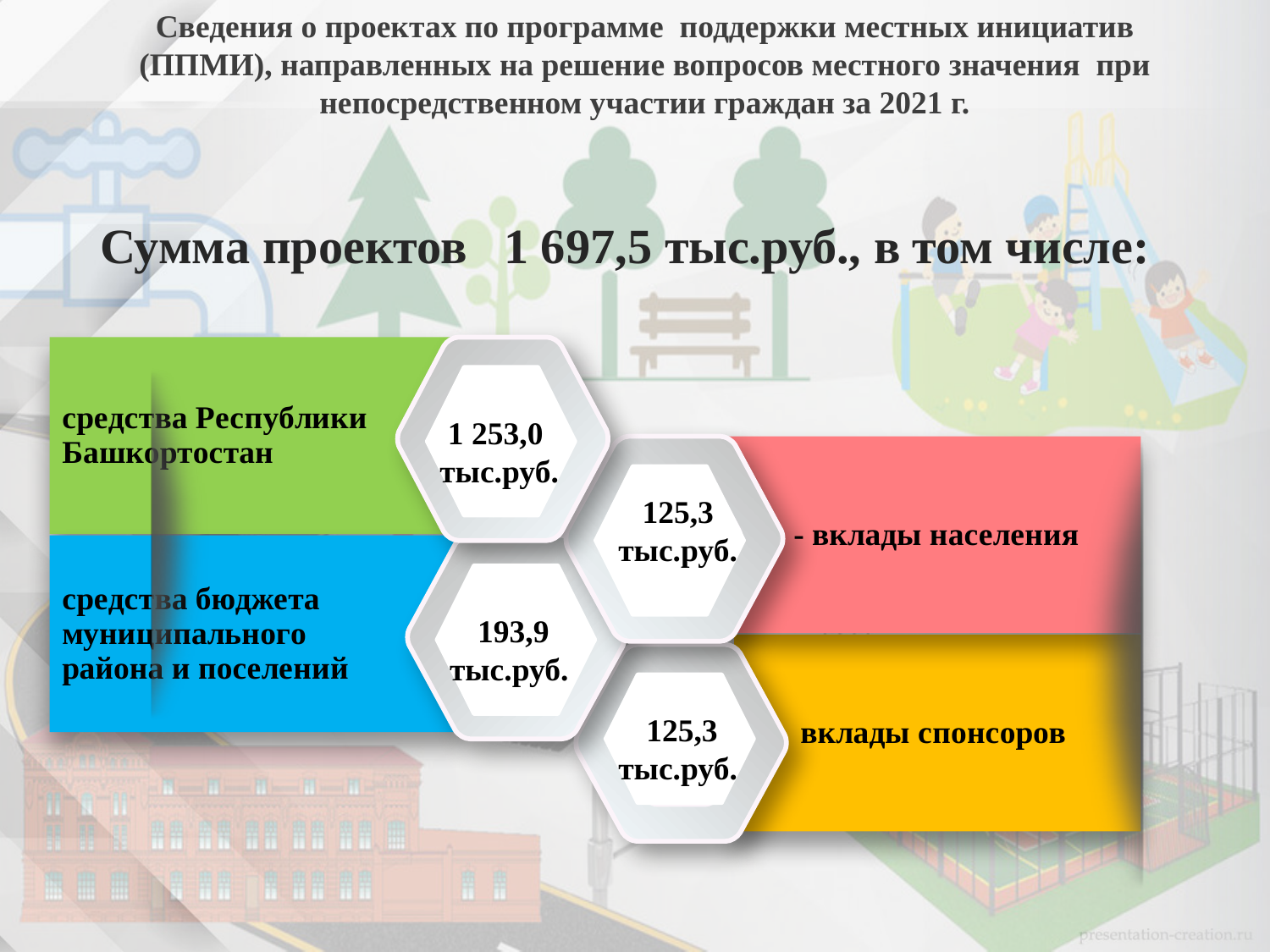
How many funding sources are shown on the slide? 4 What is the difference between средства бюджета муниципального района и поселений and вклады спонсоров? 68,6 тыс.руб. What is the value shown for средства бюджета муниципального района и поселений? 193,9 тыс.руб. Which two funding sources have the same value? вклады населения and вклады спонсоров What colour is the block for вклады спонсоров? Yellow What is the value shown for вклады населения? 125,3 тыс.руб. What is the value shown for вклады спонсоров? 125,3 тыс.руб. What is the value shown for средства Республики Башкортостан? 1 253,0 тыс.руб. Which funding source has the highest value? средства Республики Башкортостан What is the difference between средства Республики Башкортостан and средства бюджета муниципального района и поселений? 1 059,1 тыс.руб. Which is larger: средства бюджета муниципального района и поселений or вклады населения? средства бюджета муниципального района и поселений What is the total sum of the projects (Сумма проектов) stated on the slide? 1 697,5 тыс.руб.